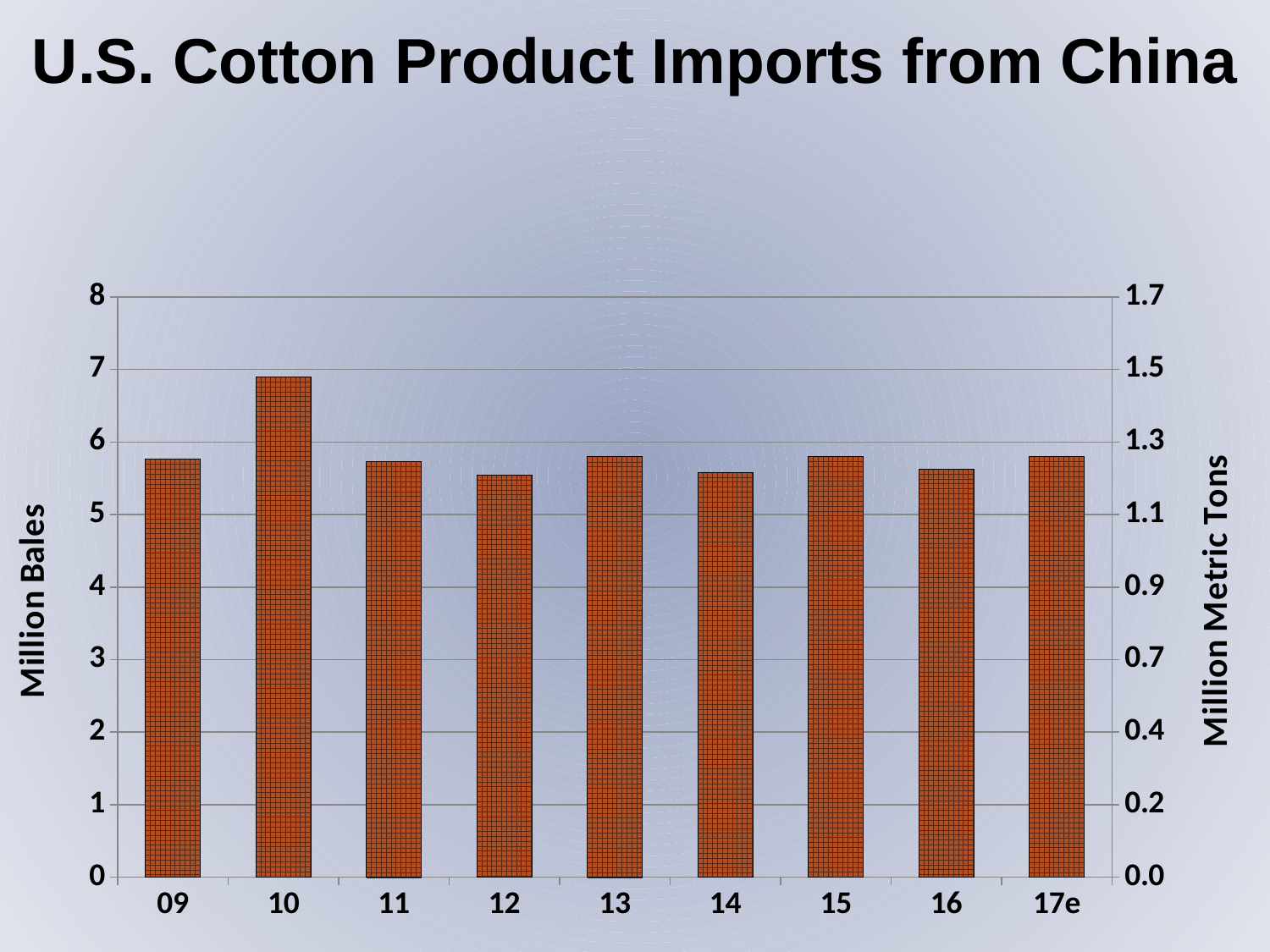
Which is larger, the value for 14 or the value for 10? 10 What type of chart is shown on the slide? bar chart Is the value for 17e greater or less than 7 million bales? less What is the label of the left vertical axis? Million Bales What is the title of the chart? U.S. Cotton Product Imports from China Is the value for 10 greater or less than 6 million bales? greater Is the value for 16 greater or less than 4 million bales? greater Which year has the highest value? 10 How many years (categories) are shown on the x axis? 9 Which is larger, the value for 10 or the value for 11? 10